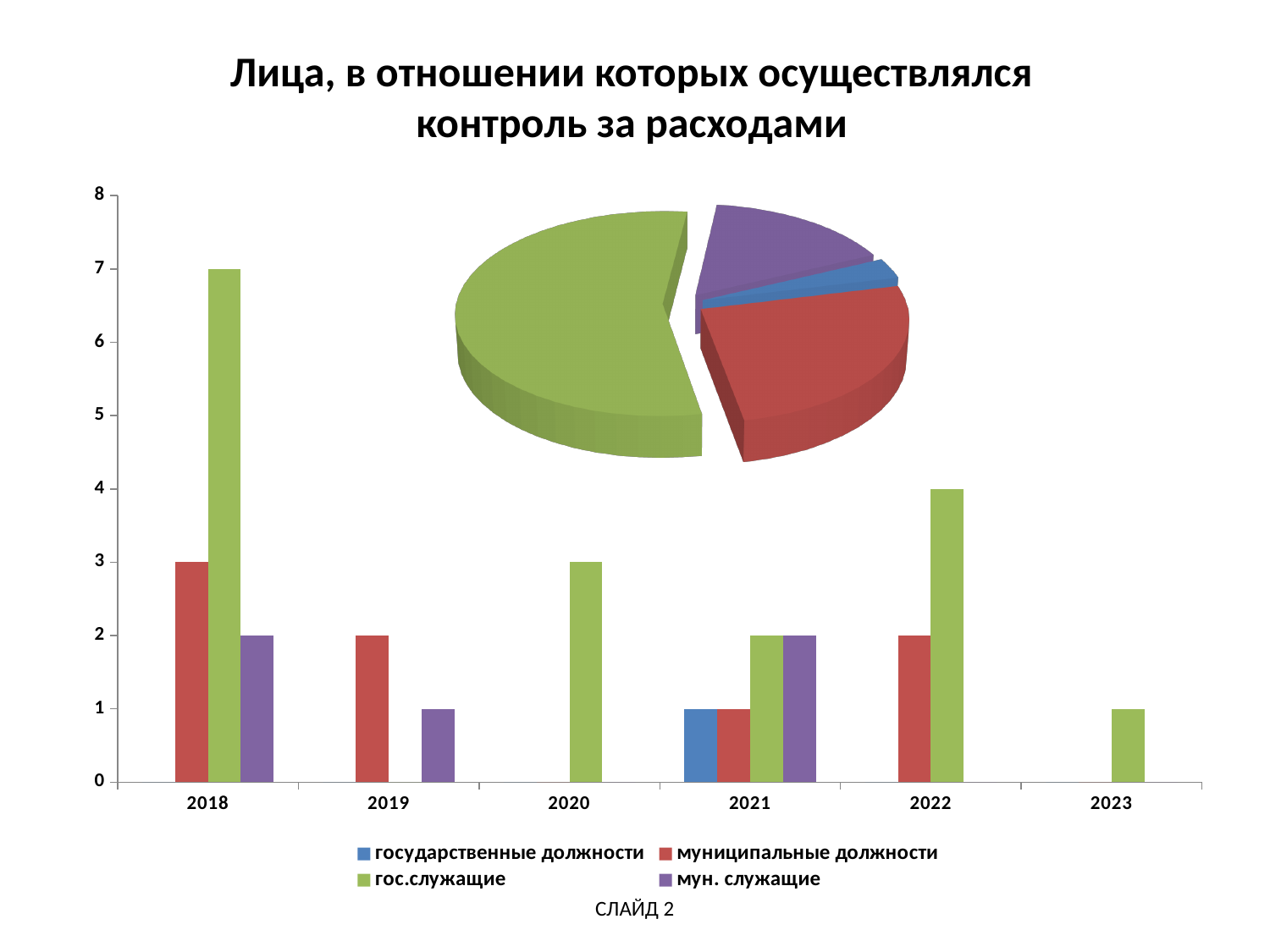
What kind of chart is the chart at the top centre of the slide? pie chart On the bar chart, in which year is the гос.служащие bar highest? 2018 On the bar chart, which is larger in 2018: муниципальные должности or мун. служащие? муниципальные должности On the bar chart, how many series does the legend list? 4 On the bar chart, which colour represents гос.служащие in the legend? green On the bar chart, what is the value for гос.служащие in 2022? 4 On the bar chart, what is the value for гос.служащие in 2018? 7 On the bar chart, what is the value for мун. служащие in 2021? 2 On the bar chart, what is the difference between гос.служащие in 2018 and гос.служащие in 2022? 3 On the bar chart, how many years are shown on the x axis? 6 On the bar chart, what is the value for муниципальные должности in 2019? 2